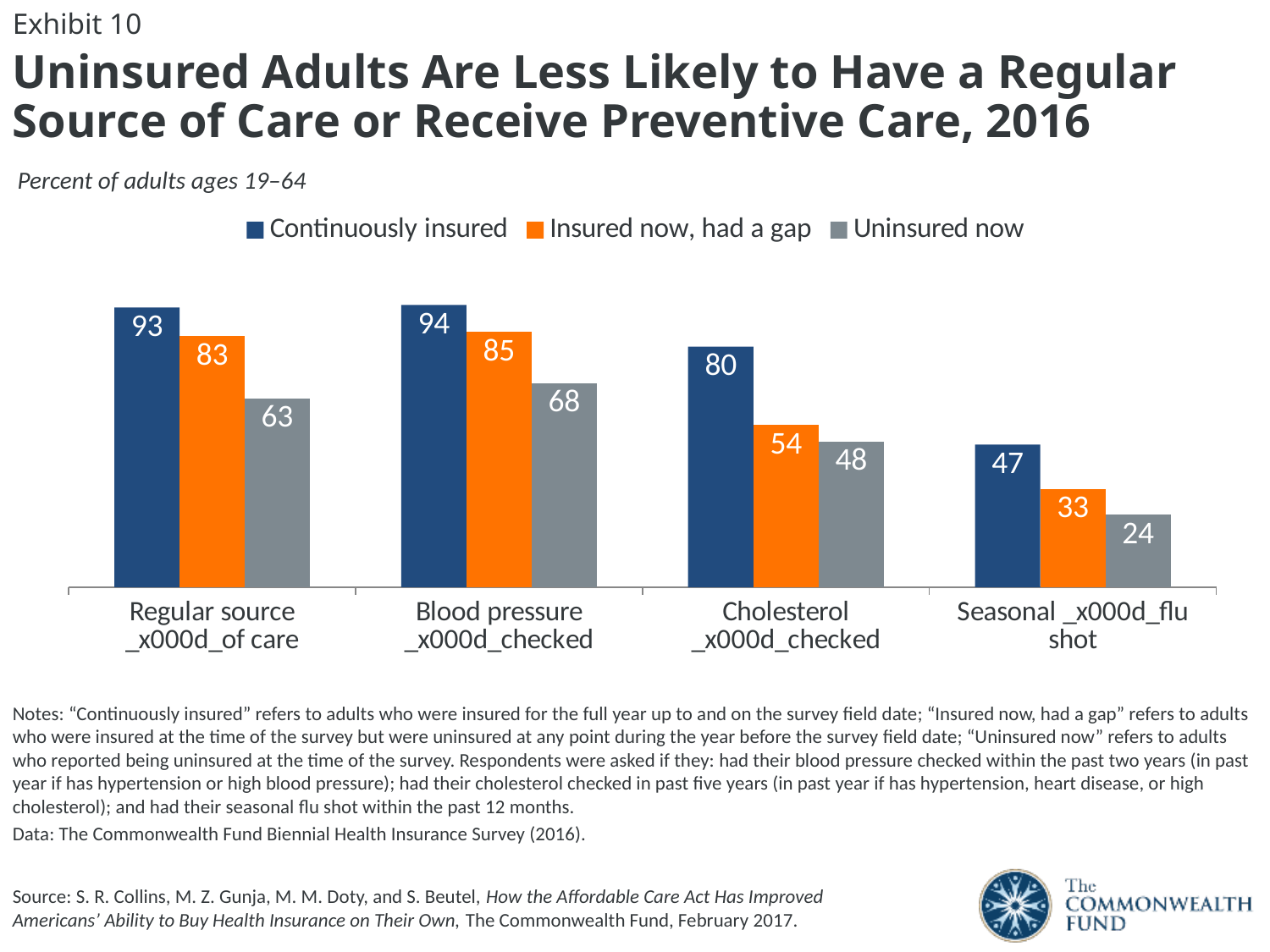
Which category has the lowest value for the Uninsured now series? Seasonal flu shot Which category has the highest value for the Continuously insured series? Blood pressure checked What percent of Uninsured now adults had a seasonal flu shot? 24 What is the value for Insured now, had a gap adults who had their cholesterol checked? 54 Which colour represents the Insured now, had a gap series? Orange Which is larger: the Uninsured now value for cholesterol checked or the Continuously insured value for seasonal flu shot? Uninsured now value for cholesterol checked What kind of chart is shown on the slide? Bar chart How many categories are shown on the x axis? 4 What is the difference between Continuously insured and Uninsured now adults for blood pressure checked? 26 How many series does the legend list? 3 What is the difference between Insured now, had a gap and Uninsured now adults for a regular source of care? 20 What is the value for Continuously insured adults with a regular source of care? 93